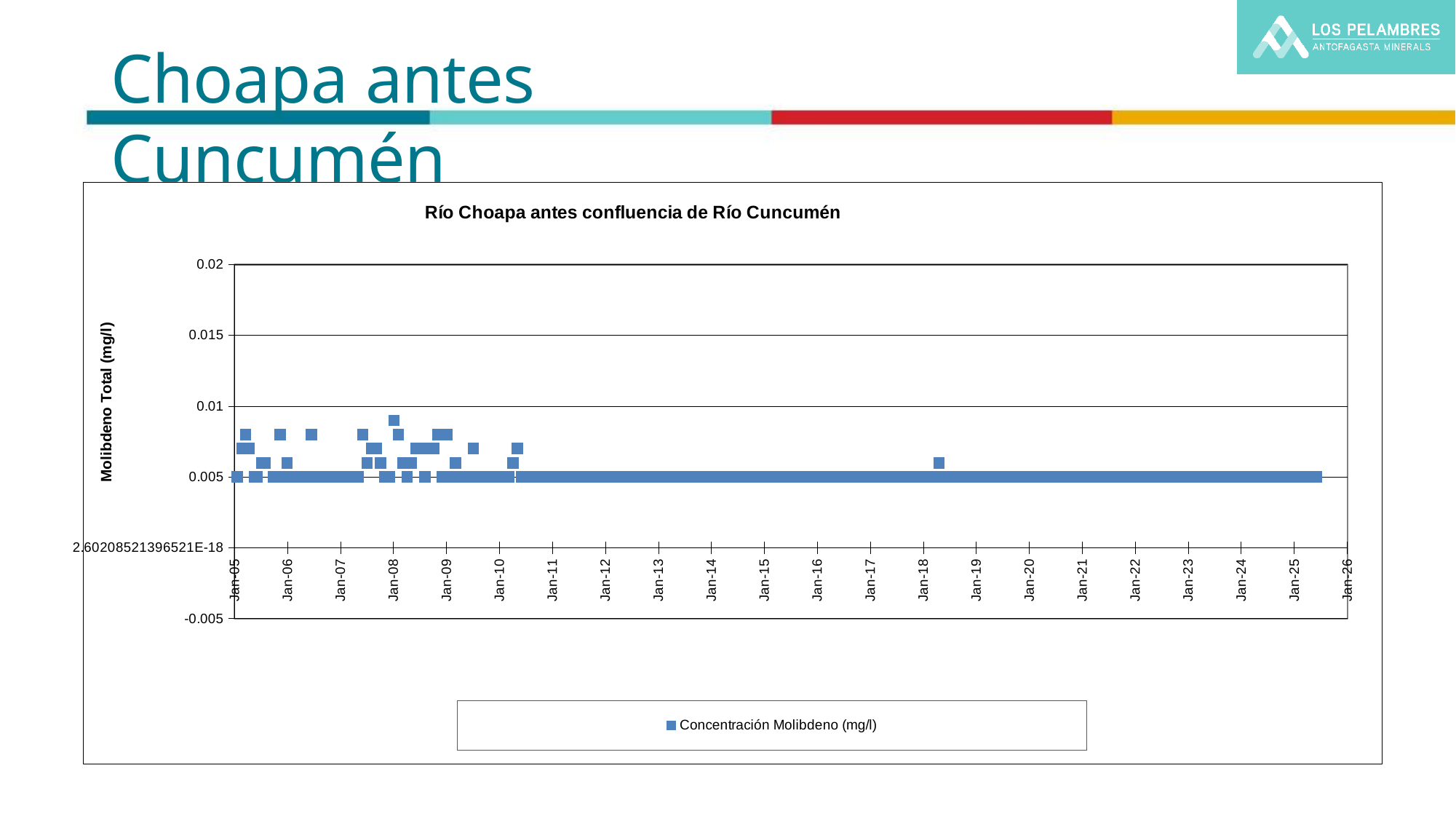
Is the highest plotted value greater or less than 0.005? greater How many series does the legend list? 1 How many year labels are shown on the x axis, from Jan-05 to Jan-26? 22 In which year range do the plotted values show the most variation: before Jan-11 or after Jan-11? before Jan-11 Are any plotted values greater than 0.015? No Is the highest plotted value greater or less than 0.01? less What is the title of the chart? Río Choapa antes confluencia de Río Cuncumén What is the name of the series shown in the legend? Concentración Molibdeno (mg/l) What is the highest value shown on the y axis? 0.02 Do the plotted values generally rise or fall from the early years (around Jan-05 to Jan-10) to the later years? fall What kind of chart is shown on the slide? scatter chart